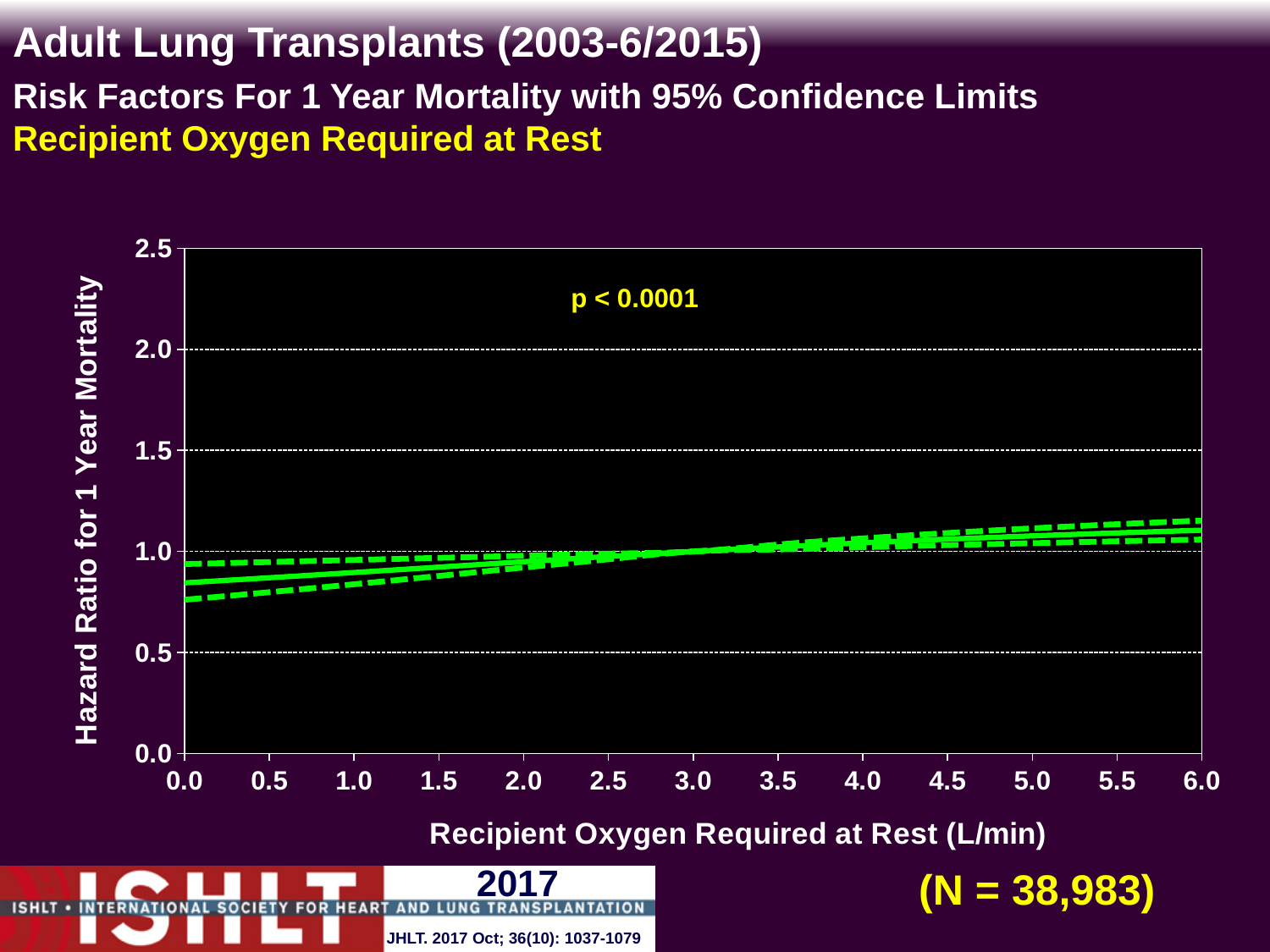
What p-value is printed on the chart? p < 0.0001 Is the hazard ratio at 6.0 L/min greater or less than 2.0? less Is the upper 95% confidence limit at 0.0 L/min greater or less than 1.0? less What is the sample size (N) shown on the slide? N = 38,983 What kind of chart is shown on the slide? line chart Does the hazard ratio for 1 year mortality rise or fall as recipient oxygen required at rest increases from 0.0 to 6.0 L/min? rise Is the lower 95% confidence limit at 0.0 L/min greater or less than 0.5? greater How many tick marks are labelled on the x axis? 13